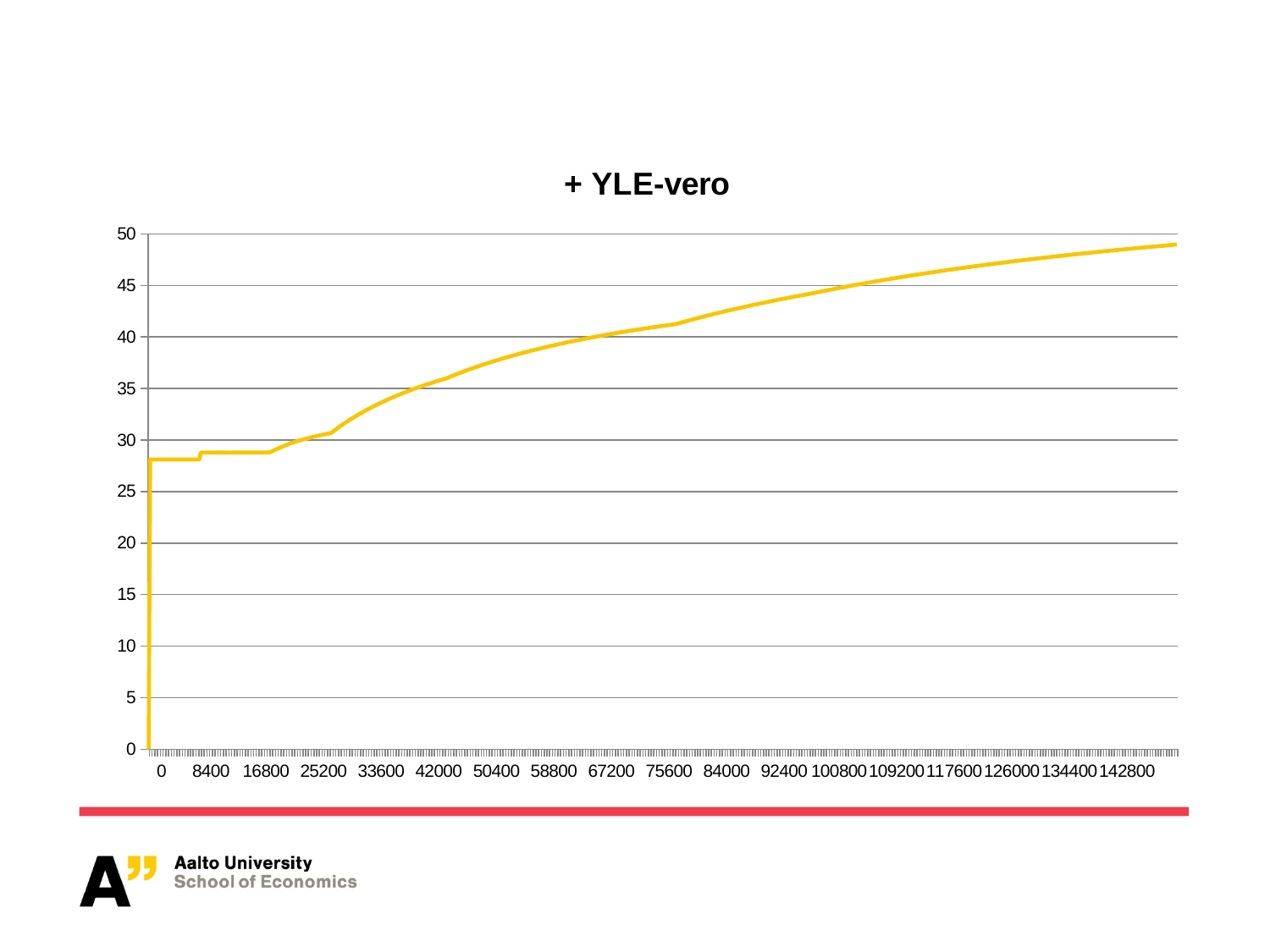
Do the values on the chart generally rise or fall as the x axis increases? rise What is the title of the chart? + YLE-vero Is the value at x = 50400 greater or less than 35? greater Which is larger, the value at x = 142800 or the value at x = 8400? 142800 Is the value at x = 16800 greater or less than 30? less Is the value at x = 117600 greater or less than 45? greater What kind of chart is shown on the slide? line chart What is the highest value shown on the y axis? 50